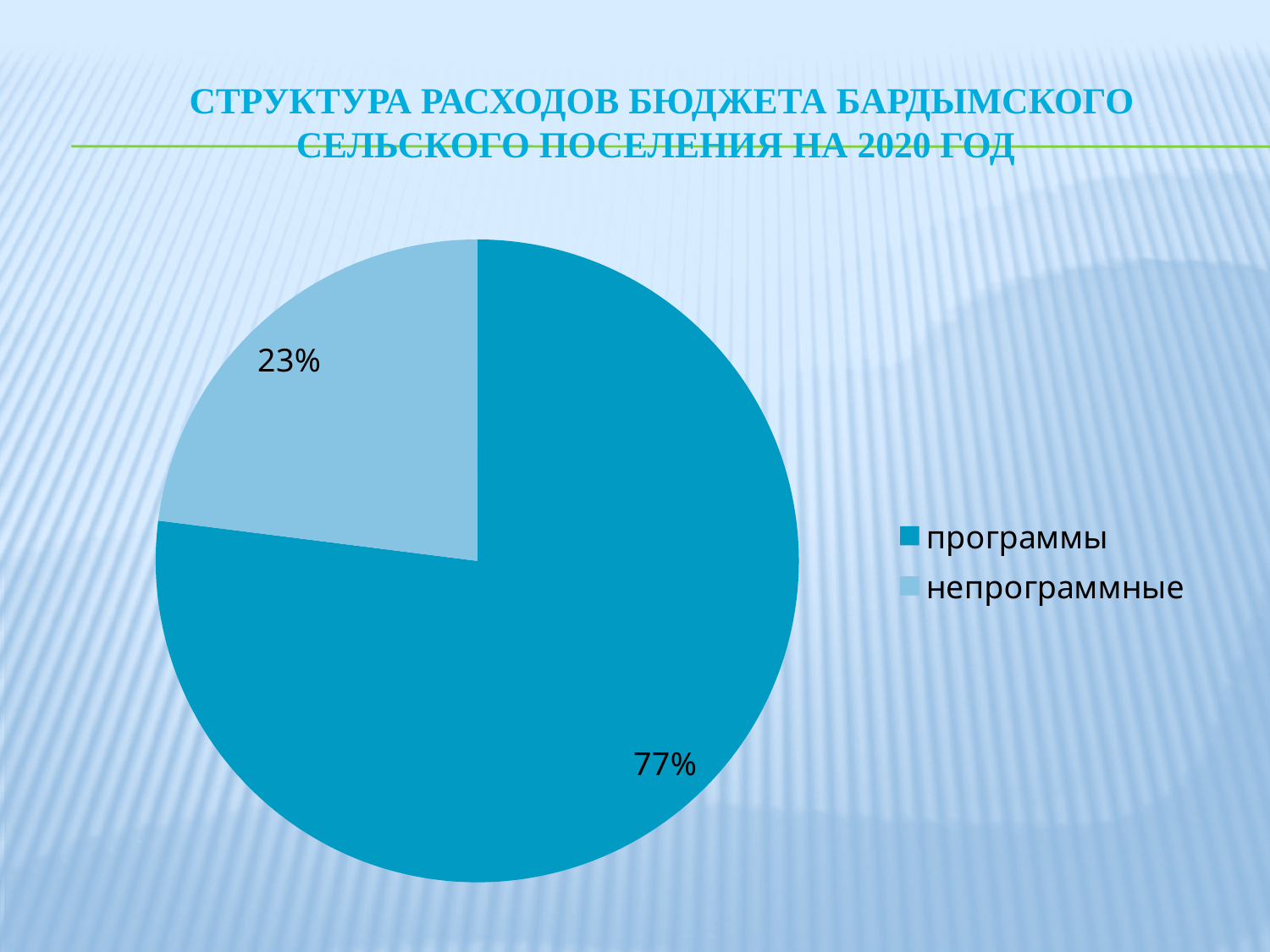
What share of the pie does "программы" take? 77% What kind of chart is shown on the slide? pie chart How many entries does the legend list? 2 What year does the slide title say the budget expenditure structure is for? 2020 Which slice is the largest? программы What share of the pie does "непрограммные" take? 23% What is the difference in percentage points between the "программы" and "непрограммные" slices? 54 Which is larger, the "программы" slice or the "непрограммные" slice? программы How many slices does the pie chart have? 2 Which slice is the smallest? непрограммные Which legend entry is shown in the lighter blue colour? непрограммные What is the total of the two slice percentages shown? 100%